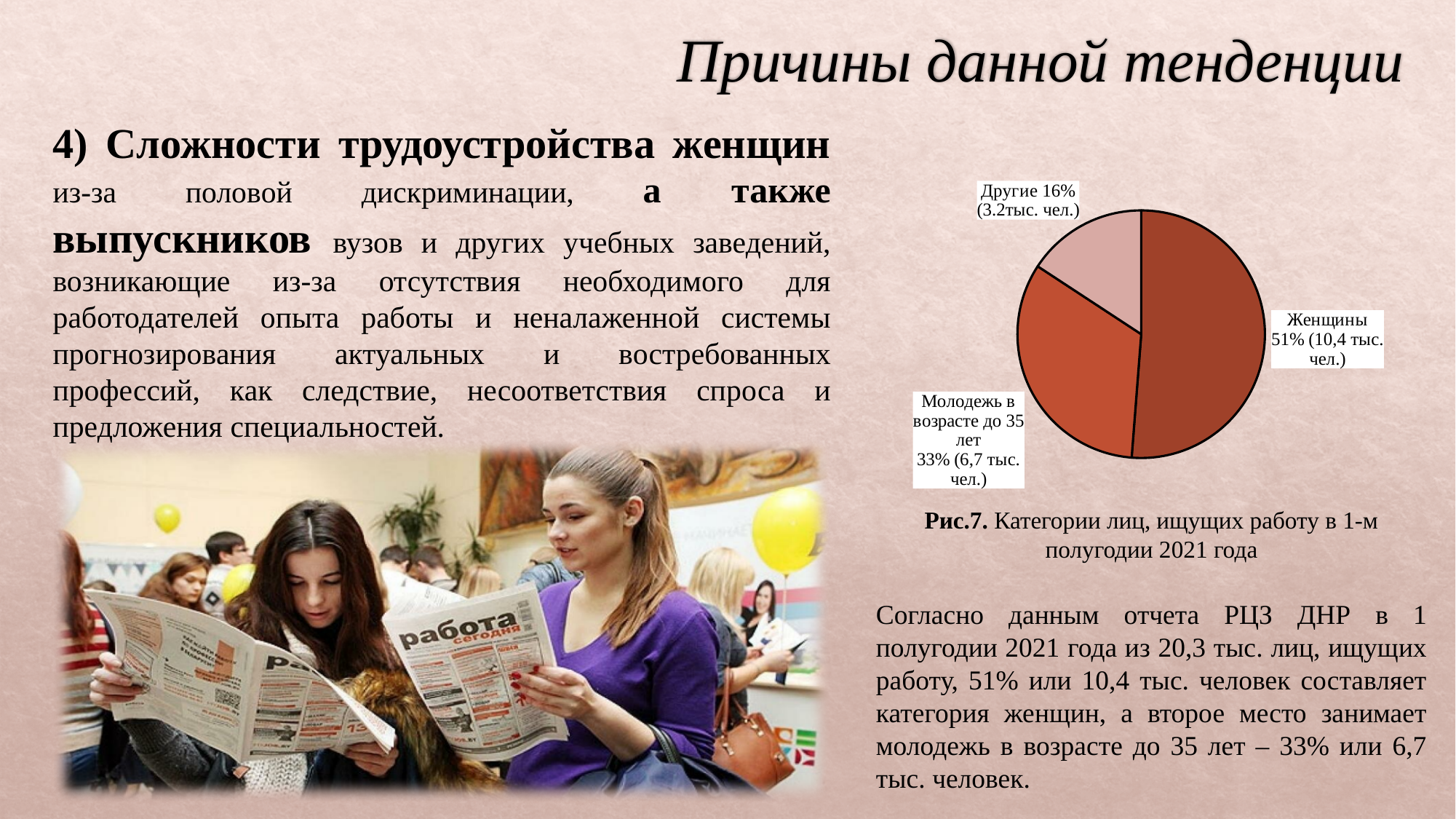
Which category has the largest slice of the pie? Женщины Which category has the smallest slice of the pie? Другие Which slice is larger: "Молодежь в возрасте до 35 лет" or "Другие"? Молодежь в возрасте до 35 лет What share of the pie does the slice "Женщины" represent? 51% What is the caption (figure title) of the pie chart? Рис.7. Категории лиц, ищущих работу в 1-м полугодии 2021 года What share of the pie does the slice "Другие" represent? 16% What kind of chart is shown on the slide? Pie chart By how many percentage points does the "Женщины" share exceed the "Молодежь в возрасте до 35 лет" share? 18 What share of the pie does the slice "Молодежь в возрасте до 35 лет" represent? 33% How many thousand people does the "Женщины" slice correspond to, according to its label? 10,4 тыс. чел. How many thousand people does the "Другие" slice correspond to, according to its label? 3.2 тыс. чел. How many slices does the pie chart have? 3